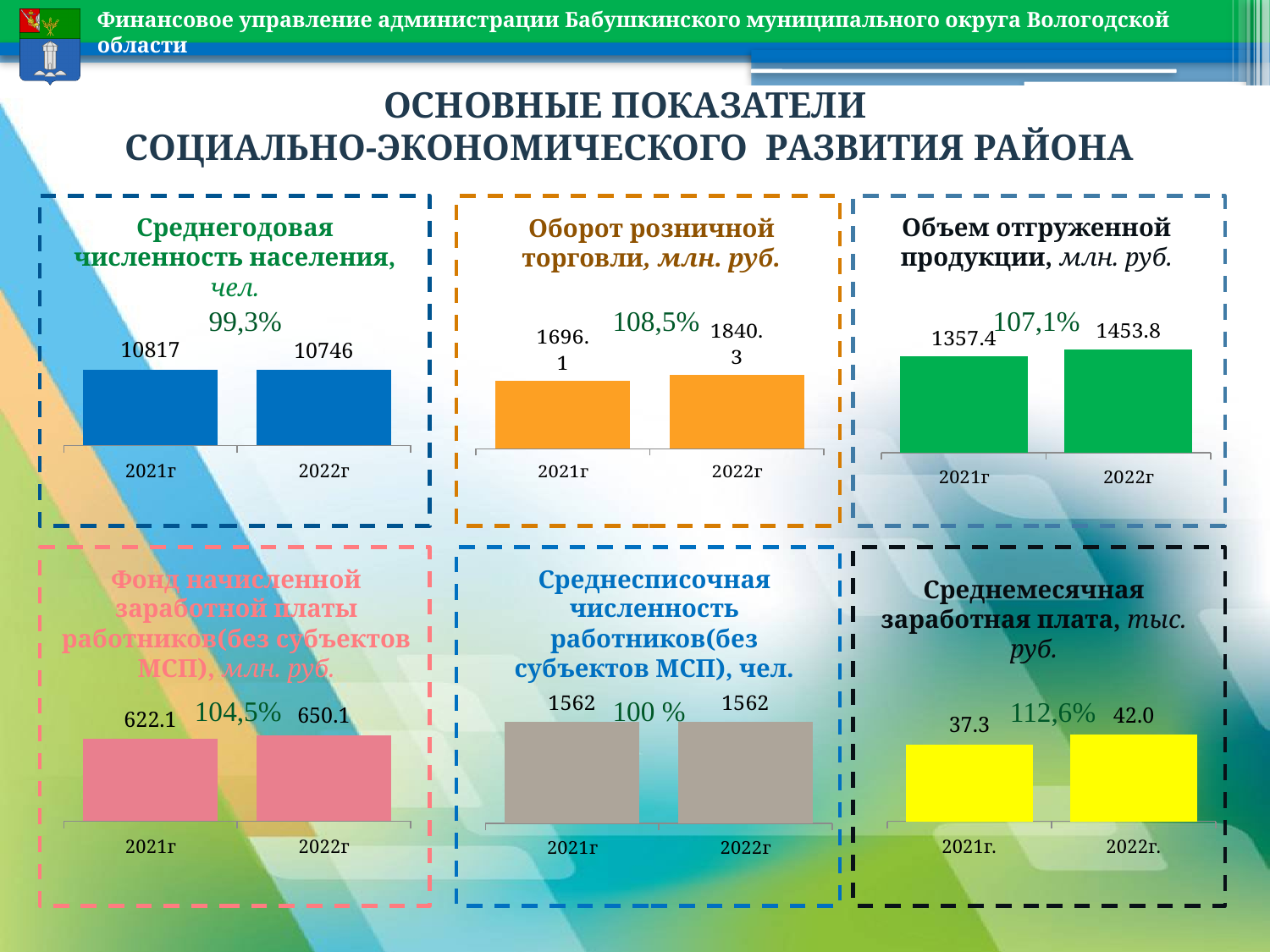
In the chart 'Объем отгруженной продукции, млн. руб.', which year has the higher value? 2022г In the chart 'Среднегодовая численность населения, чел.', what is the value for 2021г? 10817 In the chart 'Объем отгруженной продукции, млн. руб.', what is the value for 2021г? 1357.4 In the chart 'Среднесписочная численность работников (без субъектов МСП), чел.', do the values rise, fall or stay the same from 2021г to 2022г? stay the same In the chart 'Среднемесячная заработная плата, тыс. руб.', what is the difference between the 2022г. and 2021г. values? 4.7 In the chart 'Среднесписочная численность работников (без субъектов МСП), чел.', what is the value for 2021г? 1562 How many bar charts are shown on the slide? 6 In the chart 'Фонд начисленной заработной платы работников (без субъектов МСП), млн. руб.', what is the value for 2022г? 650.1 In the chart 'Оборот розничной торговли, млн. руб.', what is the value for 2022г? 1840.3 In the chart 'Оборот розничной торговли, млн. руб.', what is the difference between the 2022г and 2021г values? 144.2 In the chart 'Среднемесячная заработная плата, тыс. руб.', is the value for 2021г. larger or smaller than the value for 2022г.? smaller In the chart 'Среднегодовая численность населения, чел.', which year has the lower value? 2022г